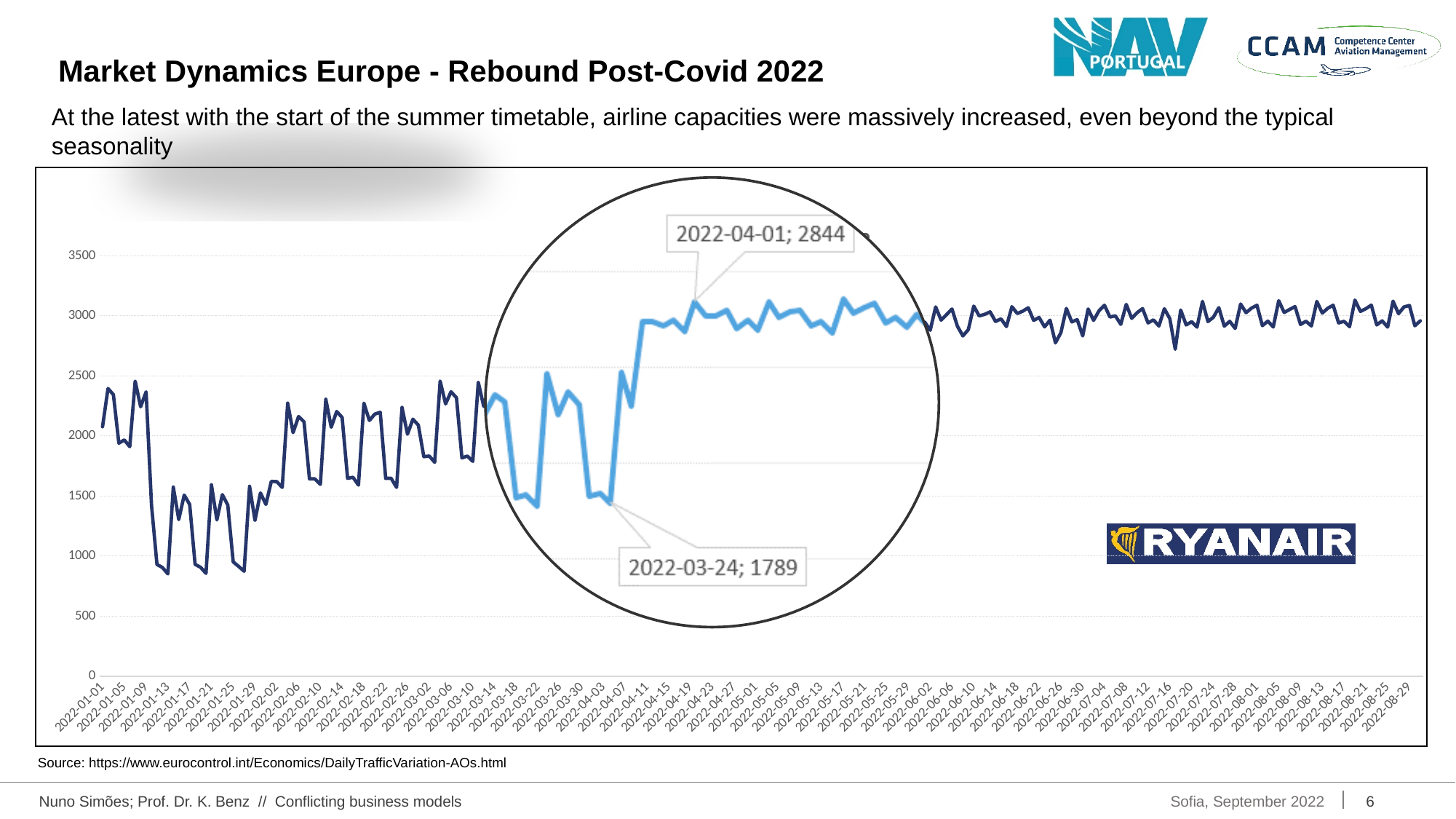
What is the difference between the labelled values for 2022-04-01 and 2022-03-24? 1055 Which date has the larger labelled value, 2022-04-01 or 2022-03-24? 2022-04-01 What value is labelled on the chart for 2022-04-01? 2844 What kind of chart is shown on the slide? line chart Which airline's logo is shown on the chart? Ryanair What value is labelled on the chart for 2022-03-24? 1789 What is the highest value shown on the vertical axis? 3500 Is the value on 2022-08-29 greater or less than 2500? greater Overall, do the values rise or fall from January 2022 to August 2022? rise Is the value around 2022-01-13 greater or less than 1000? less